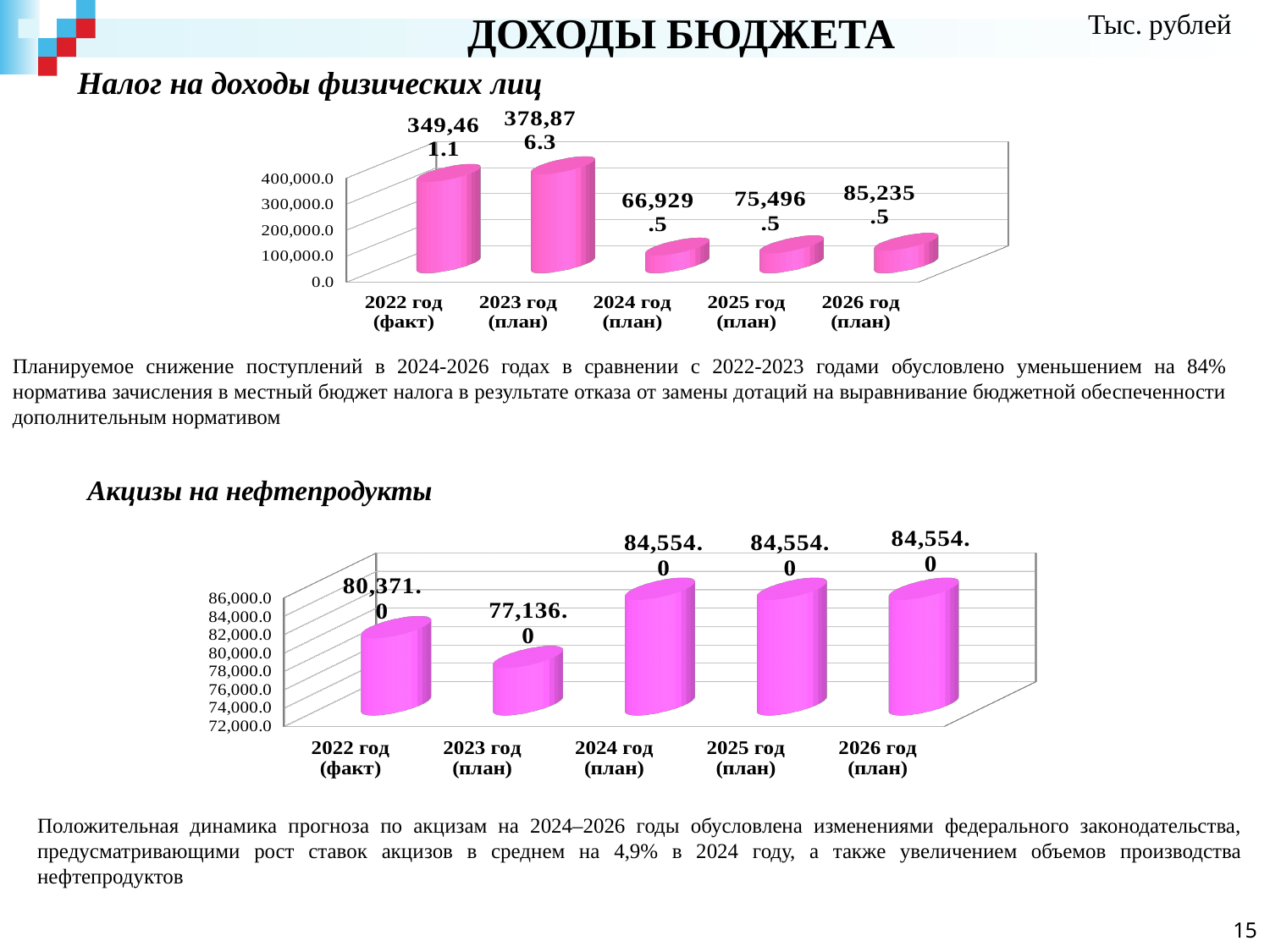
On the 'Акцизы на нефтепродукты' chart, what is the value for 2023 год (план)? 77,136.0 What type of chart is the 'Акцизы на нефтепродукты' chart? Bar chart On the 'Акцизы на нефтепродукты' chart, what is the difference between the values for 2024 год (план) and 2023 год (план)? 7,418.0 On the 'Налог на доходы физических лиц' chart, which year has the highest value? 2023 год (план) On the 'Акцизы на нефтепродукты' chart, what is the value for 2022 год (факт)? 80,371.0 On the 'Акцизы на нефтепродукты' chart, is the value for 2022 год (факт) larger or smaller than the value for 2024 год (план)? smaller On the 'Акцизы на нефтепродукты' chart, which year has the lowest value? 2023 год (план) On the 'Налог на доходы физических лиц' chart, what is the value for 2024 год (план)? 66,929.5 On the 'Налог на доходы физических лиц' chart, how many years are shown? 5 On the 'Налог на доходы физических лиц' chart, what is the difference between the values for 2026 год (план) and 2025 год (план)? 9,739.0 On the 'Налог на доходы физических лиц' chart, what is the value for 2023 год (план)? 378,876.3 On the 'Налог на доходы физических лиц' chart, which year has the lowest value? 2024 год (план)